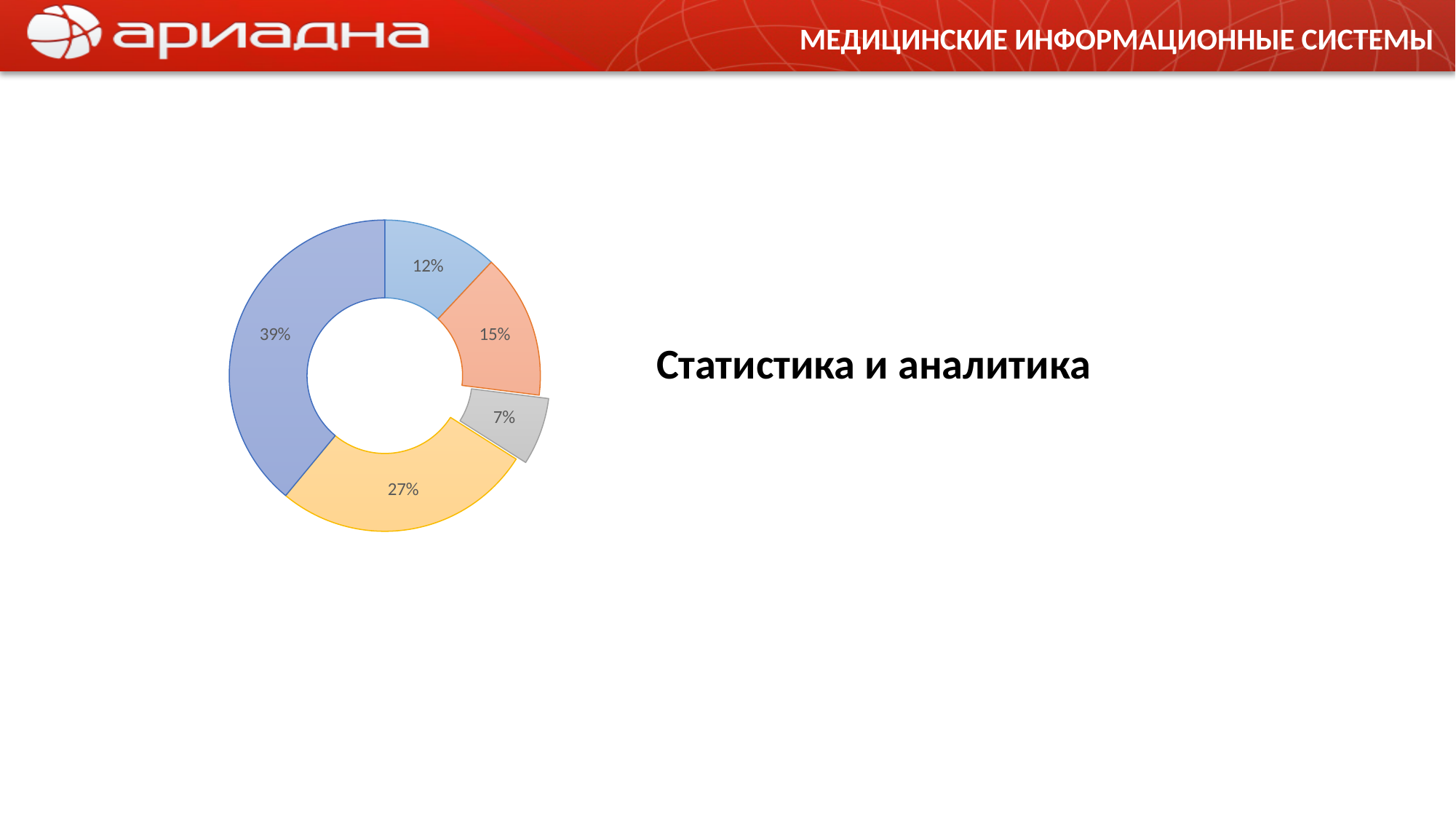
How many slices does the doughnut chart have? 5 Which slice is larger: the orange slice or the light blue slice? The orange slice (15%) What percentage is shown on the yellow slice of the doughnut chart? 27% What colour is the largest slice of the doughnut chart? Blue What is the difference in percentage points between the largest slice (39%) and the yellow slice (27%)? 12 What text appears to the right of the doughnut chart? Статистика и аналитика What percentage is shown on the light blue slice at the top of the doughnut chart? 12% What percentage is shown on the grey slice of the doughnut chart? 7% What percentage is shown on the largest slice of the doughnut chart? 39% What percentage is shown on the smallest slice of the doughnut chart? 7% What kind of chart is shown on the slide? Doughnut chart What percentage is shown on the orange slice of the doughnut chart? 15%